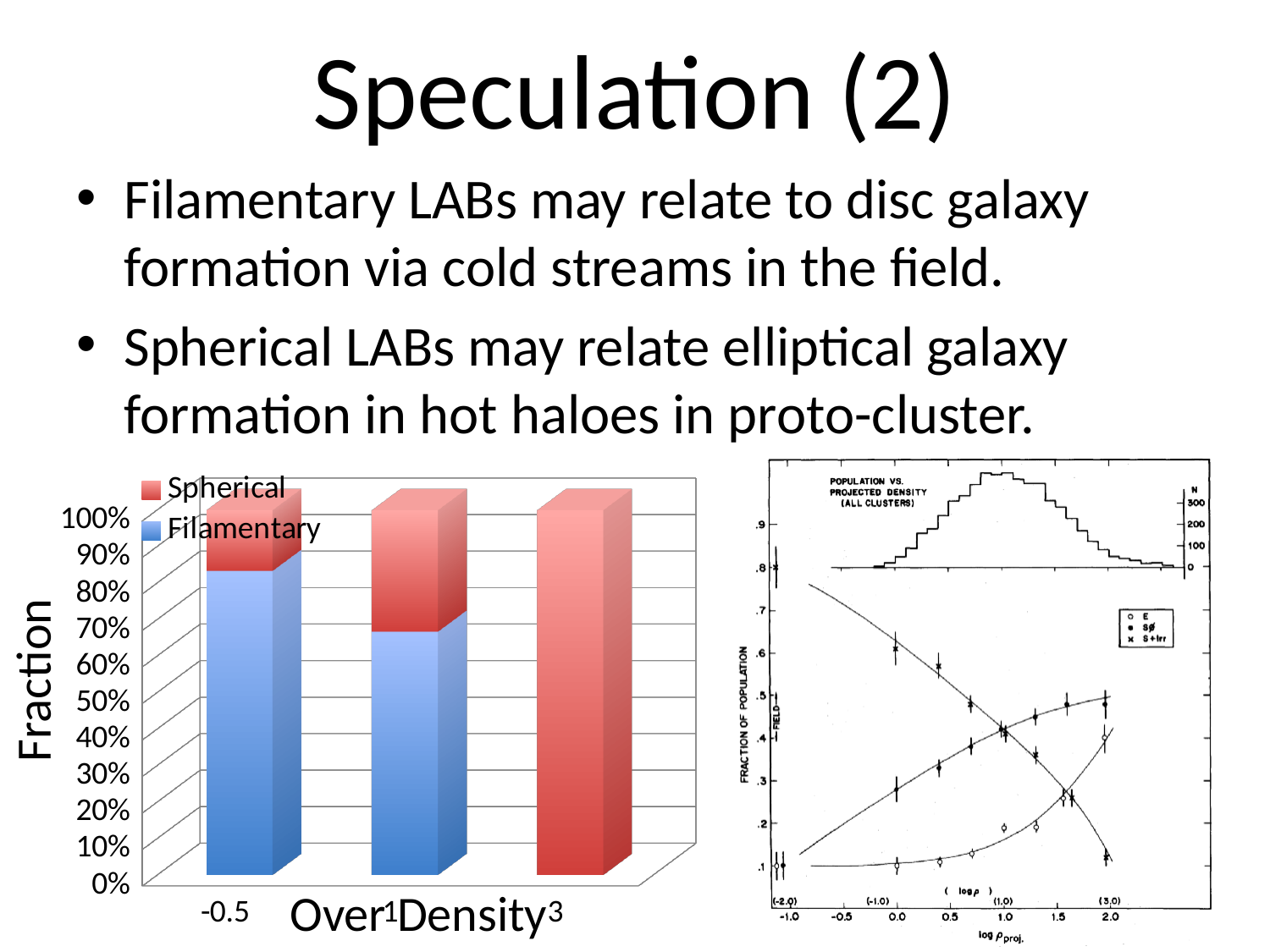
What kind of chart is the chart on the left of the slide? Stacked bar chart On the left chart, which Over Density category has the lowest Spherical fraction? -0.5 On the left chart, does the Filamentary fraction rise or fall as Over Density increases? fall On the left chart, is the Filamentary fraction at Over Density 1 greater or less than 80%? less How many Over Density categories are shown on the left chart? 3 On the left chart, which Over Density category has the larger Filamentary fraction, -0.5 or 1? -0.5 On the left chart, is the Spherical fraction at Over Density 1 greater or less than 50%? less On the left chart, is the Filamentary fraction at Over Density -0.5 greater or less than 70%? greater What are the two series named in the legend of the left chart? Spherical and Filamentary On the left chart, which Over Density category has the highest Spherical fraction? 3 What is the y-axis title of the left chart? Fraction How many series does the legend of the left chart list? 2